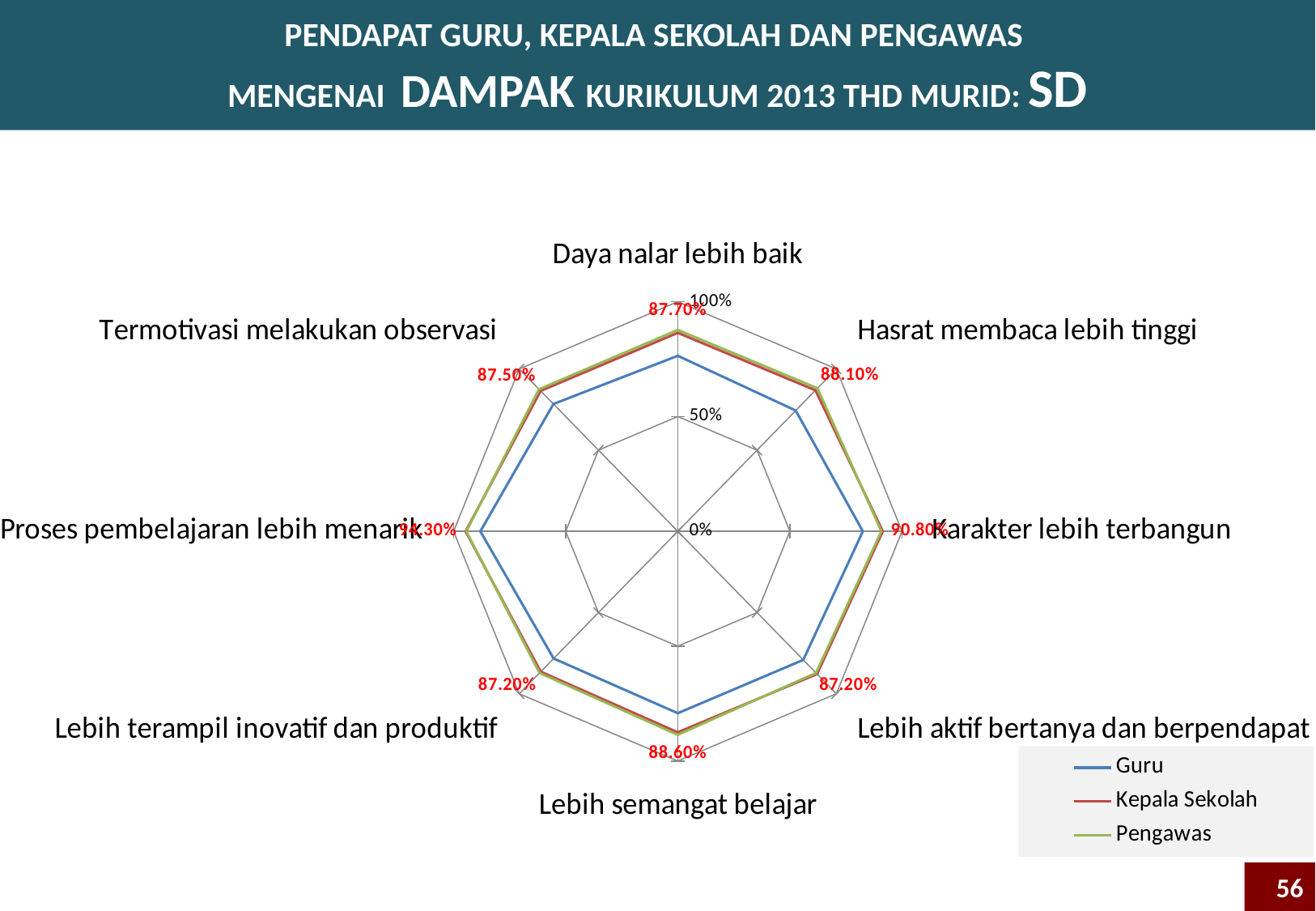
For 'Karakter lebih terbangun', which series is larger: Guru or Pengawas? Pengawas What is the data label shown for 'Lebih semangat belajar'? 88.60% Which series is drawn in blue in the legend? Guru Which category has the highest labelled value? Proses pembelajaran lebih menarik What kind of chart is shown on the slide? Radar chart Is the Guru value for 'Daya nalar lebih baik' greater or less than 50%? greater What is the difference between the labelled values for 'Proses pembelajaran lebih menarik' and 'Daya nalar lebih baik'? 6.60% How many series does the legend list? 3 What is the data label shown for 'Proses pembelajaran lebih menarik'? 94.30% What is the data label shown for 'Karakter lebih terbangun'? 90.80% What is the data label shown for 'Daya nalar lebih baik'? 87.70% How many categories (axes) does the radar chart have? 8